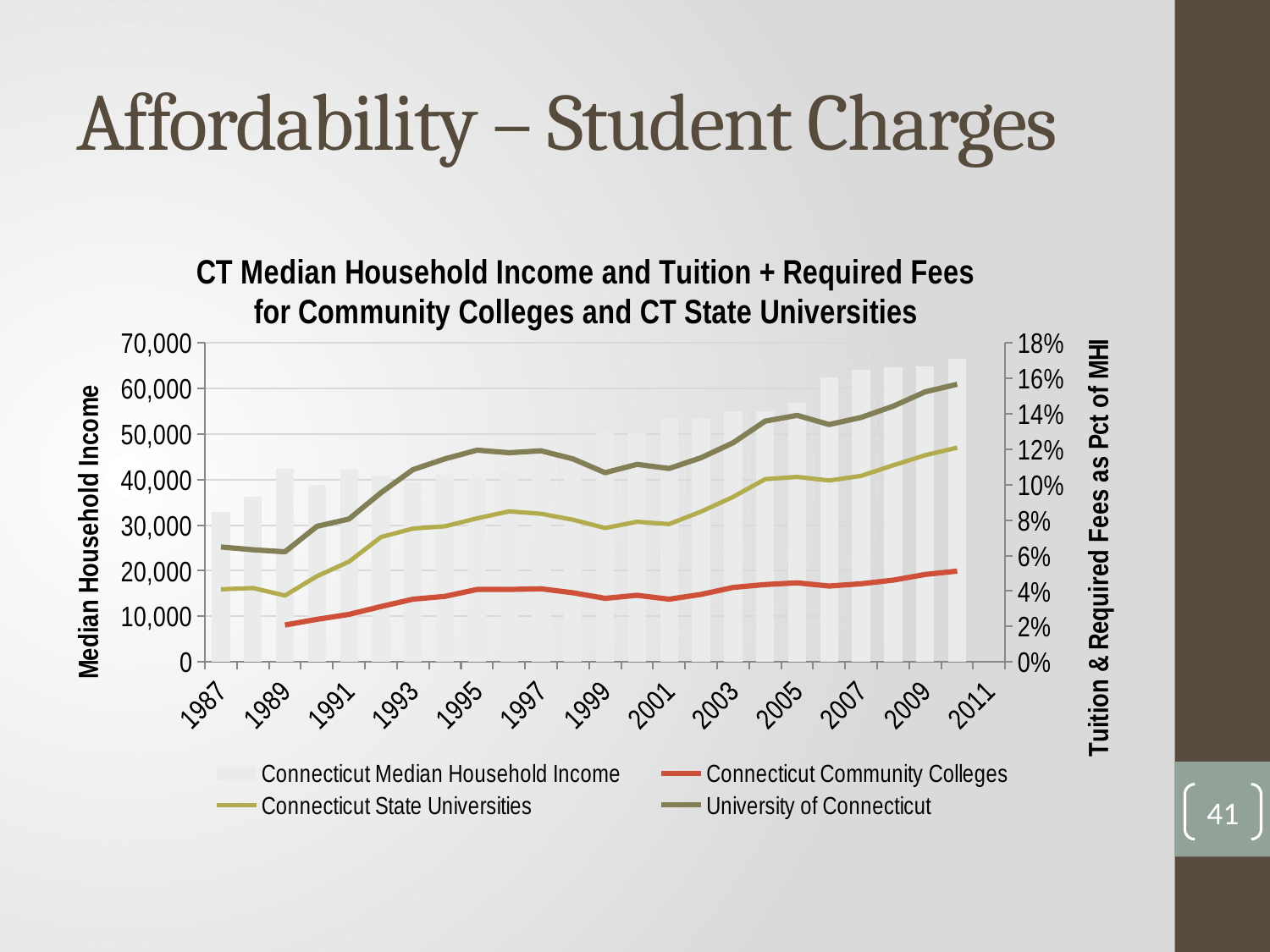
In 2005, which is larger: the University of Connecticut value or the Connecticut Community Colleges value? University of Connecticut Which series has the lowest tuition and fees as a percent of median household income across the chart? Connecticut Community Colleges What is the label of the right-hand vertical axis? Tuition & Required Fees as Pct of MHI What kind of chart is shown on the slide? A combination bar and line chart What is the title of the chart? CT Median Household Income and Tuition + Required Fees for Community Colleges and CT State Universities Which series has the highest tuition and fees as a percent of median household income in 2010? University of Connecticut Does the University of Connecticut line generally rise or fall from 1987 to 2010? rise Is the University of Connecticut value in 2010 greater or less than 14%? greater Is the Connecticut Median Household Income bar for 2010 greater or less than 60,000? greater Is the Connecticut Median Household Income bar for 1987 greater or less than 40,000? less How many series does the legend list? 4